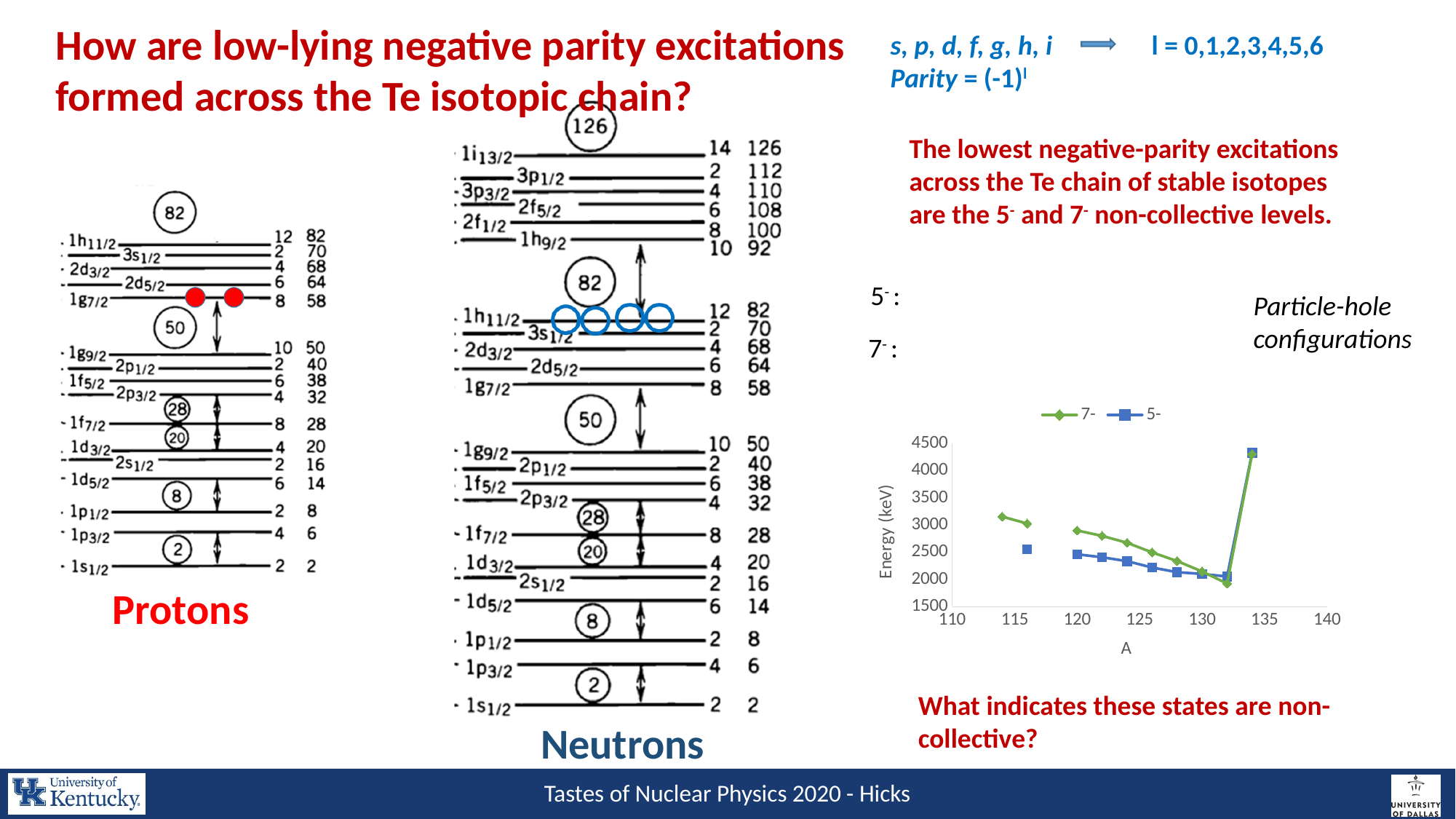
At A = 120, which series has the higher energy, 7- or 5-? 7- For the 7- series, which is larger: the value at A = 132 or the value at A = 134? A = 134 What are the two series named in the chart legend? 7- and 5- Does the 7- series rise or fall as A increases from 114 to 132? fall Is the 5- value at A = 116 greater or less than 3000? less How many series does the legend of the chart list? 2 Is the 7- value at A = 114 greater or less than 2500? greater Is the 7- value at A = 132 greater or less than 2500? less What is the label of the vertical axis of the chart? Energy (keV) What kind of chart is shown on the slide? line chart